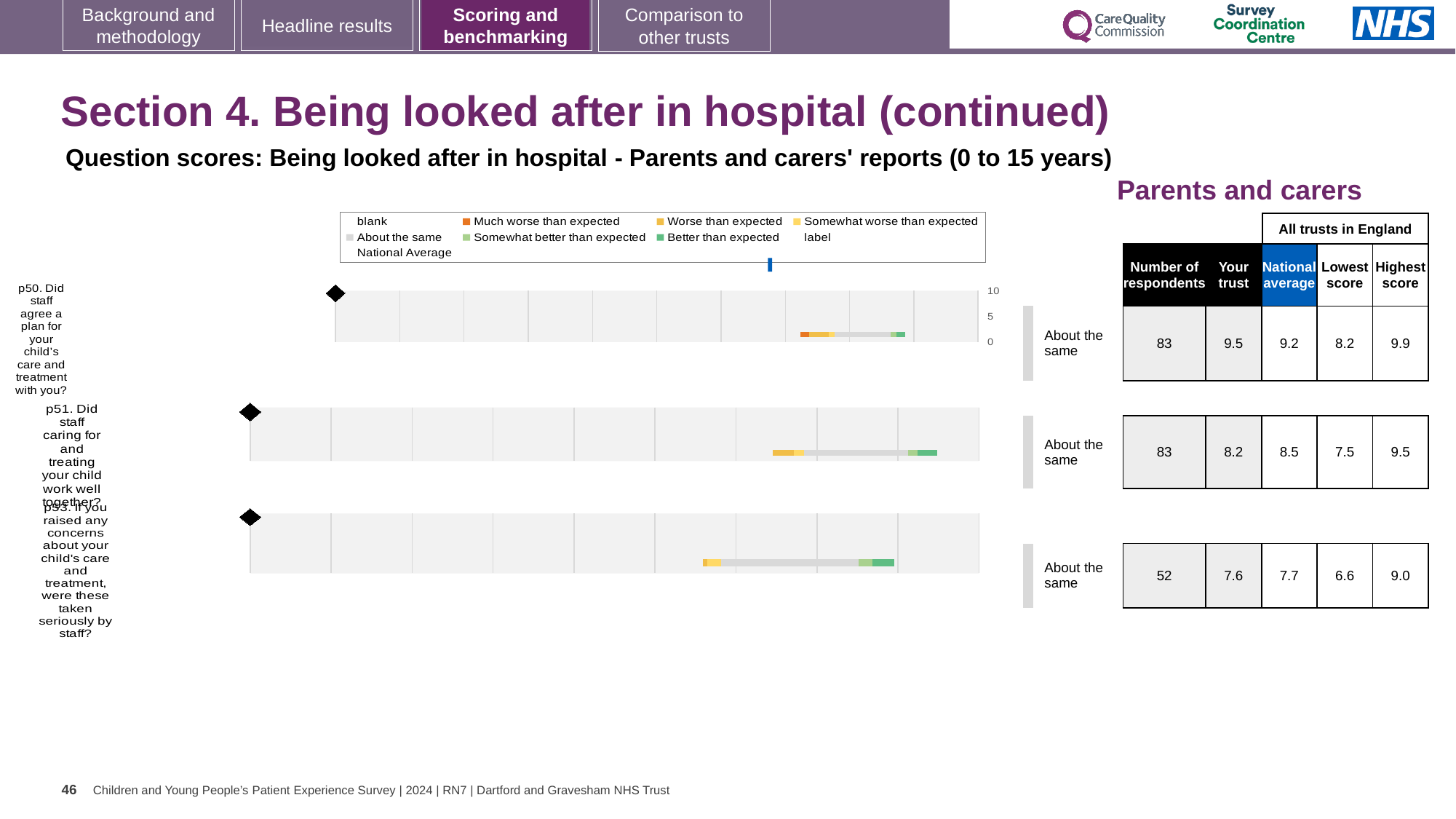
Which of the three questions shown has the highest 'Your trust' score? p50 What is the national average score for p51 (Did staff caring for and treating your child work well together?)? 8.5 How many survey questions are plotted on this slide? 3 Which of the three questions shown has the lowest national average score? p53 What benchmarking category is shown next to the chart for p53? About the same What is the highest score among all trusts in England for p50? 9.9 What kind of chart is used to show each question's score? Bar chart What is the difference between the national average (8.5) and the 'Your trust' score (8.2) for p51? 0.3 What is the lowest score among all trusts in England for p53? 6.6 What is the 'Your trust' score for p50 (Did staff agree a plan for your child's care and treatment with you?)? 9.5 How many respondents are recorded for p53 (If you raised any concerns about your child's care and treatment, were these taken seriously by staff?)? 52 For p50, which is larger: the 'Your trust' score or the national average? Your trust